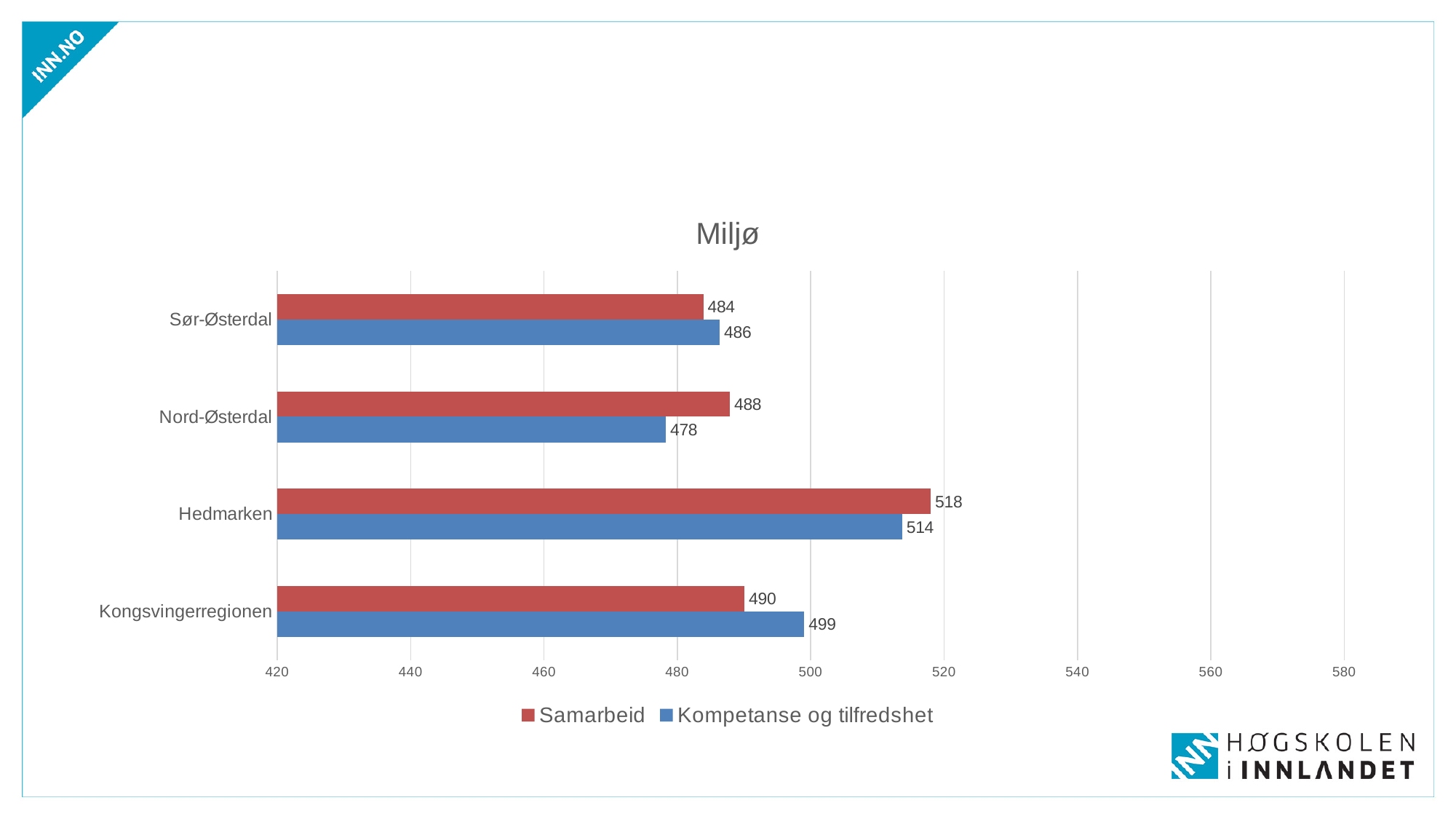
How many series does the legend list? 2 What is the Kompetanse og tilfredshet value for Nord-Østerdal? 478 What is the difference between the Samarbeid and Kompetanse og tilfredshet values for Kongsvingerregionen? 9 Which region has the highest Samarbeid value? Hedmarken For Nord-Østerdal, which is larger: Samarbeid or Kompetanse og tilfredshet? Samarbeid How many regions are shown on the chart? 4 What is the Kompetanse og tilfredshet value for Kongsvingerregionen? 499 Is the Samarbeid value for Sør-Østerdal greater or less than 500? less What kind of chart is shown? bar chart What is the Samarbeid value for Hedmarken? 518 What is the title of the chart? Miljø Which region has the lowest Kompetanse og tilfredshet value? Nord-Østerdal